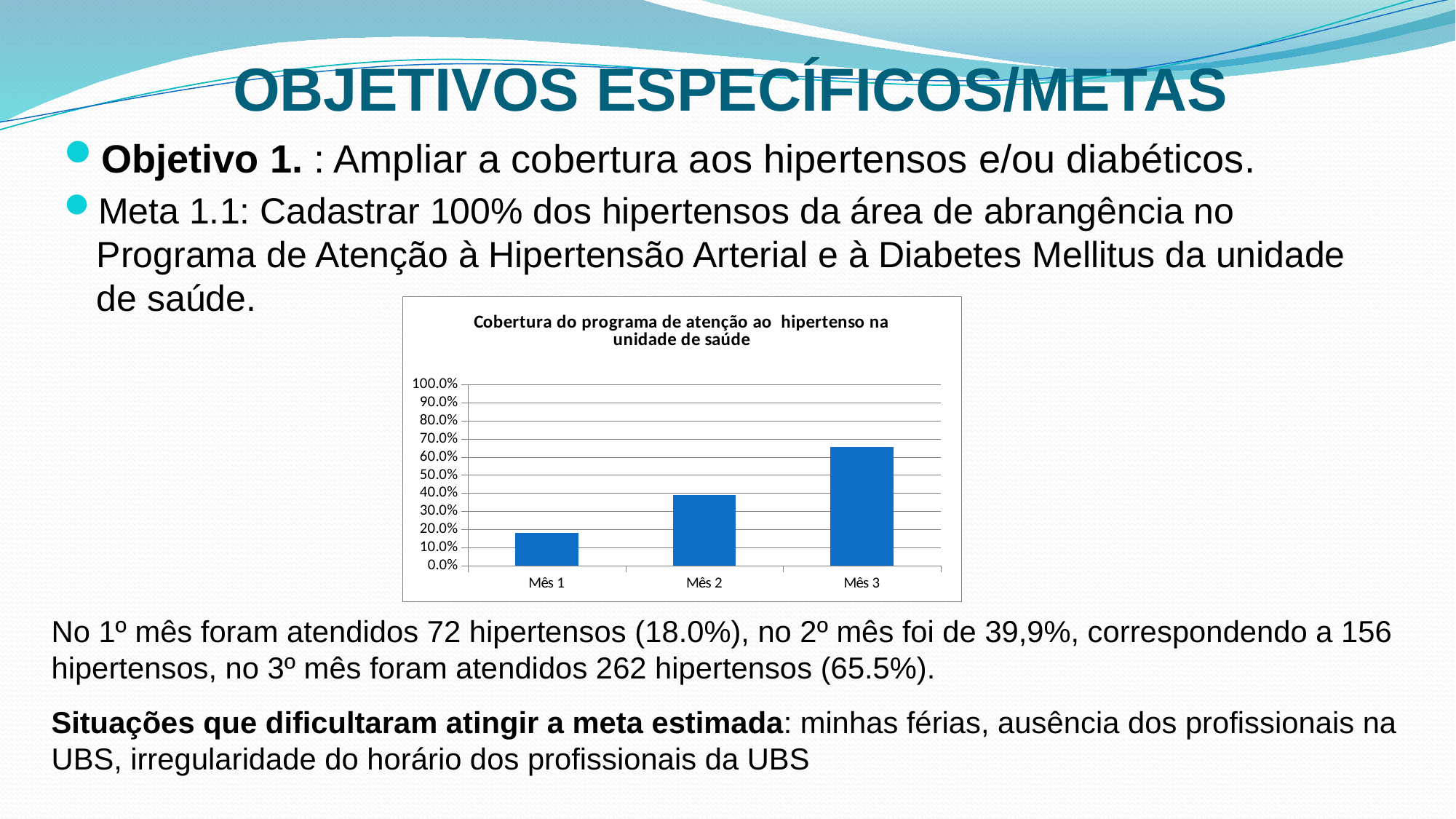
What is the maximum value shown on the y axis of the chart? 100.0% Which is larger, the value for Mês 2 or the value for Mês 1? Mês 2 Is the value for Mês 2 greater or less than 30.0%? greater Which month has the lowest bar in the chart? Mês 1 What is the title of the chart? Cobertura do programa de atenção ao hipertenso na unidade de saúde Is the value for Mês 3 greater or less than 60.0%? greater How many categories are shown on the x axis of the chart? 3 Which month has the highest bar in the chart? Mês 3 What kind of chart is shown on the slide? bar chart Is the value for Mês 3 greater or less than 70.0%? less Do the values rise or fall from Mês 1 to Mês 3? rise